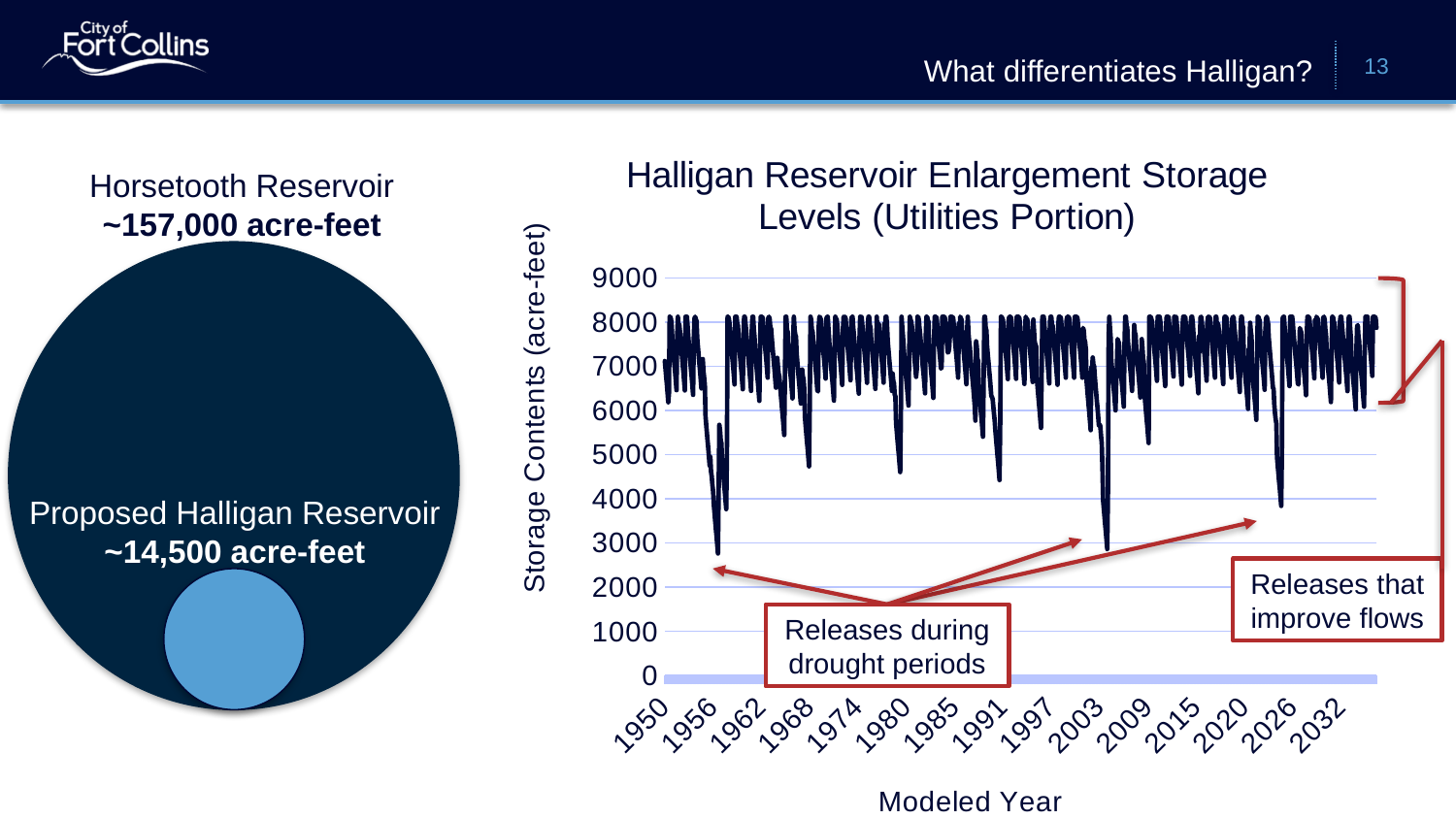
What is the highest value shown on the y-axis of the Halligan Reservoir Enlargement Storage Levels chart? 9000 How many year tick labels are shown on the x-axis of the Halligan Reservoir Enlargement Storage Levels chart? 15 On the Halligan Reservoir Enlargement Storage Levels chart, is the lowest storage level reached around 2003 greater or less than 4000 acre-feet? less What is the last year shown on the x-axis of the Halligan Reservoir Enlargement Storage Levels chart? 2032 What is the label of the y-axis on the Halligan Reservoir Enlargement Storage Levels chart? Storage Contents (acre-feet) On the Halligan Reservoir Enlargement Storage Levels chart, are the peak storage levels greater or less than 7000 acre-feet? greater What kind of chart is shown on the right side of the slide? Line chart On the Halligan Reservoir Enlargement Storage Levels chart, which is lower: the storage dip around 1980 or the storage dip around 2003? The dip around 2003 On the Halligan Reservoir Enlargement Storage Levels chart, is the lowest storage level reached around 1956 greater or less than 4000 acre-feet? less What is the first year shown on the x-axis of the Halligan Reservoir Enlargement Storage Levels chart? 1950 What is the title of the chart on the right side of the slide? Halligan Reservoir Enlargement Storage Levels (Utilities Portion)